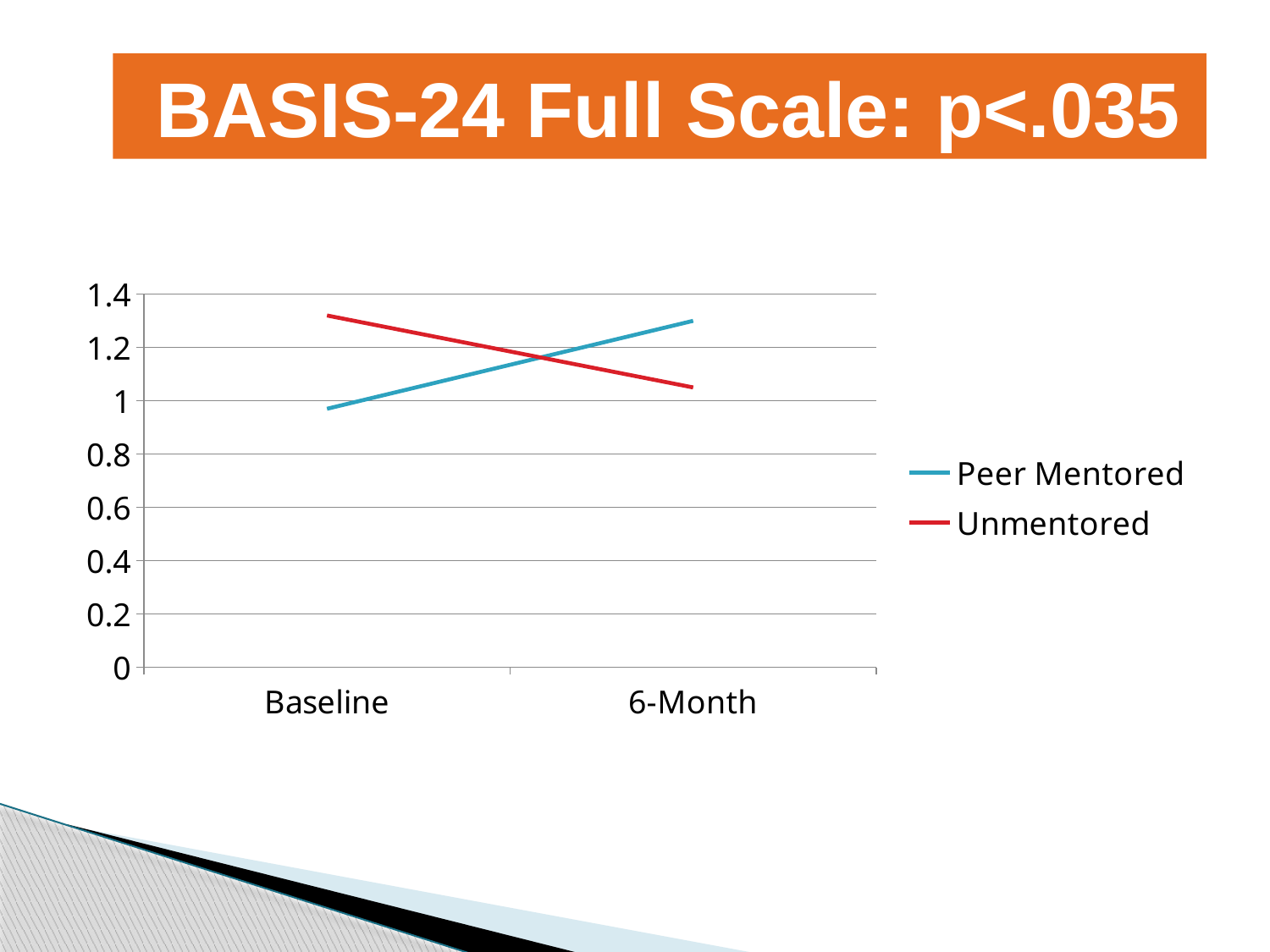
Does the Peer Mentored line rise or fall from Baseline to 6-Month? rise How many time points are shown on the x axis? 2 How many series does the legend list? 2 At Baseline, which series has the higher value, Peer Mentored or Unmentored? Unmentored Which colour is used for the Unmentored line? red Does the Unmentored line rise or fall from Baseline to 6-Month? fall Is the value for Peer Mentored at 6-Month greater or less than 1.2? greater Is the value for Unmentored at 6-Month greater or less than 1.2? less What is the title of the chart? BASIS-24 Full Scale: p<.035 Is the value for Unmentored at Baseline greater or less than 1.2? greater What kind of chart is shown on the slide? line chart At 6-Month, which series has the higher value, Peer Mentored or Unmentored? Peer Mentored